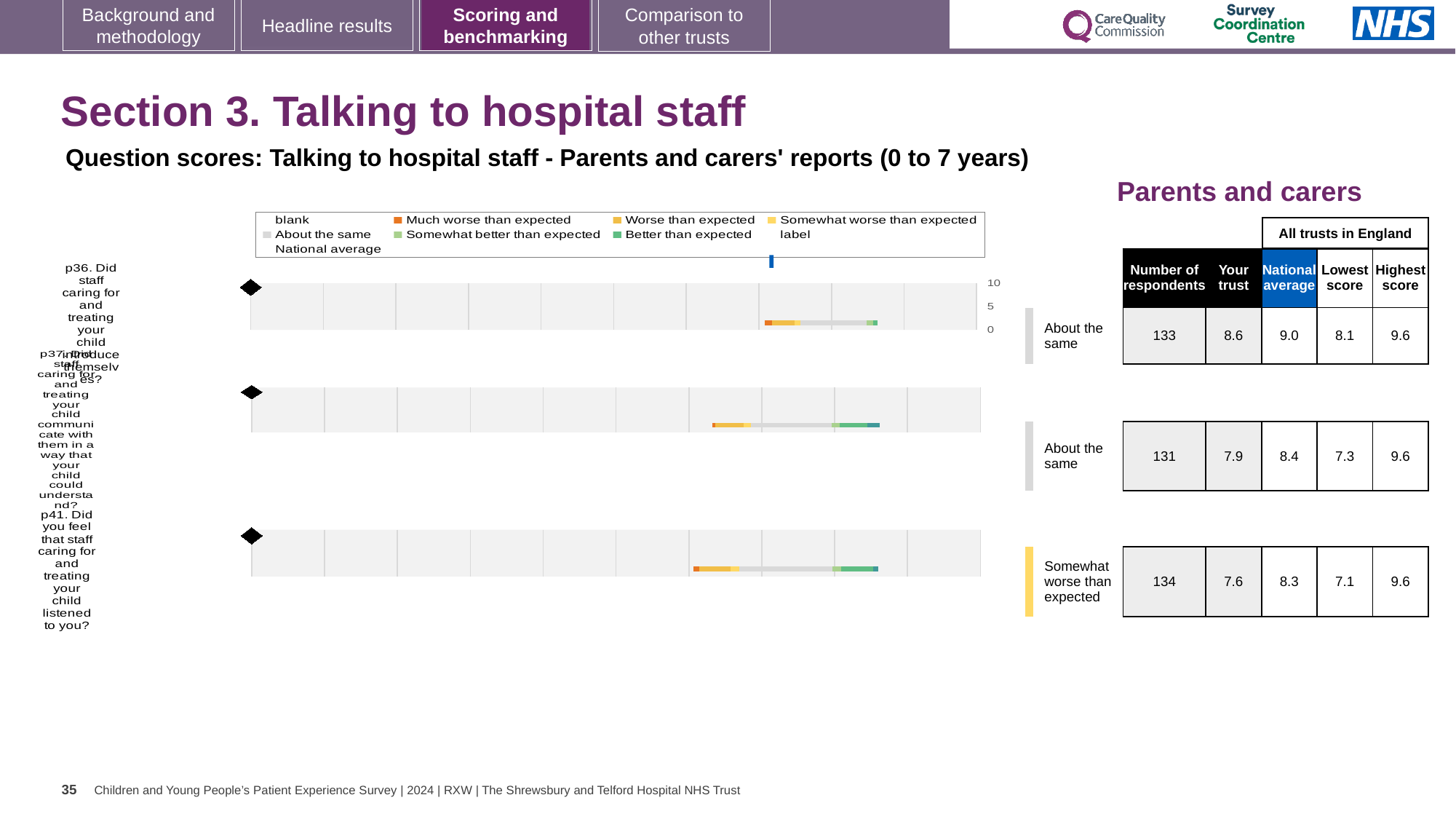
How many respondents answered question p41? 134 What is the 'Your trust' score for question p36? 8.6 For question p37, what is the difference between the highest score and the lowest score across all trusts in England? 2.3 What benchmark category is shown for question p41? Somewhat worse than expected What kind of chart is used to show the question scores on this slide? bar chart What is the national average score for question p37? 8.4 Which has the larger 'Your trust' score, p37 or p41? p37 What is the highest score across all trusts in England for question p37? 9.6 For question p36, how much higher is the national average than the trust's score? 0.4 Which question has the highest 'Your trust' score? p36 How many survey questions are plotted in the chart? 3 Which question has the lowest 'Your trust' score? p41